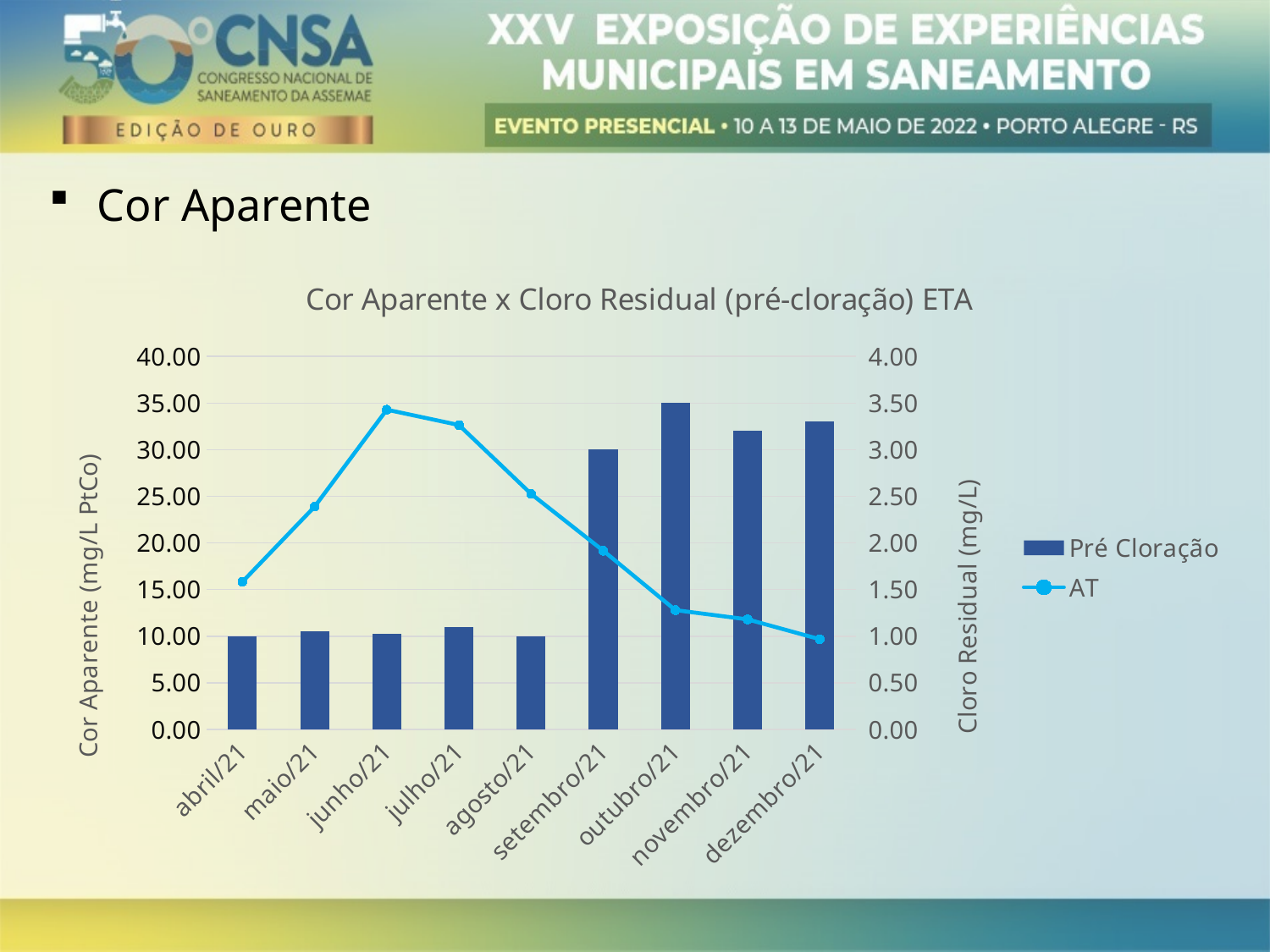
Does the AT line rise or fall from junho/21 to dezembro/21? It falls What kind of chart is shown on the slide? A combination bar and line chart Which has the larger Pré Cloração value, outubro/21 or novembro/21? outubro/21 Which month has the lowest AT value? dezembro/21 How many series does the legend list? 2 What is the title of the chart? Cor Aparente x Cloro Residual (pré-cloração) ETA What is the label of the right-hand vertical axis? Cloro Residual (mg/L) How many months are shown on the x axis? 9 Which month has the highest Pré Cloração bar? outubro/21 Which month has the highest AT value? junho/21